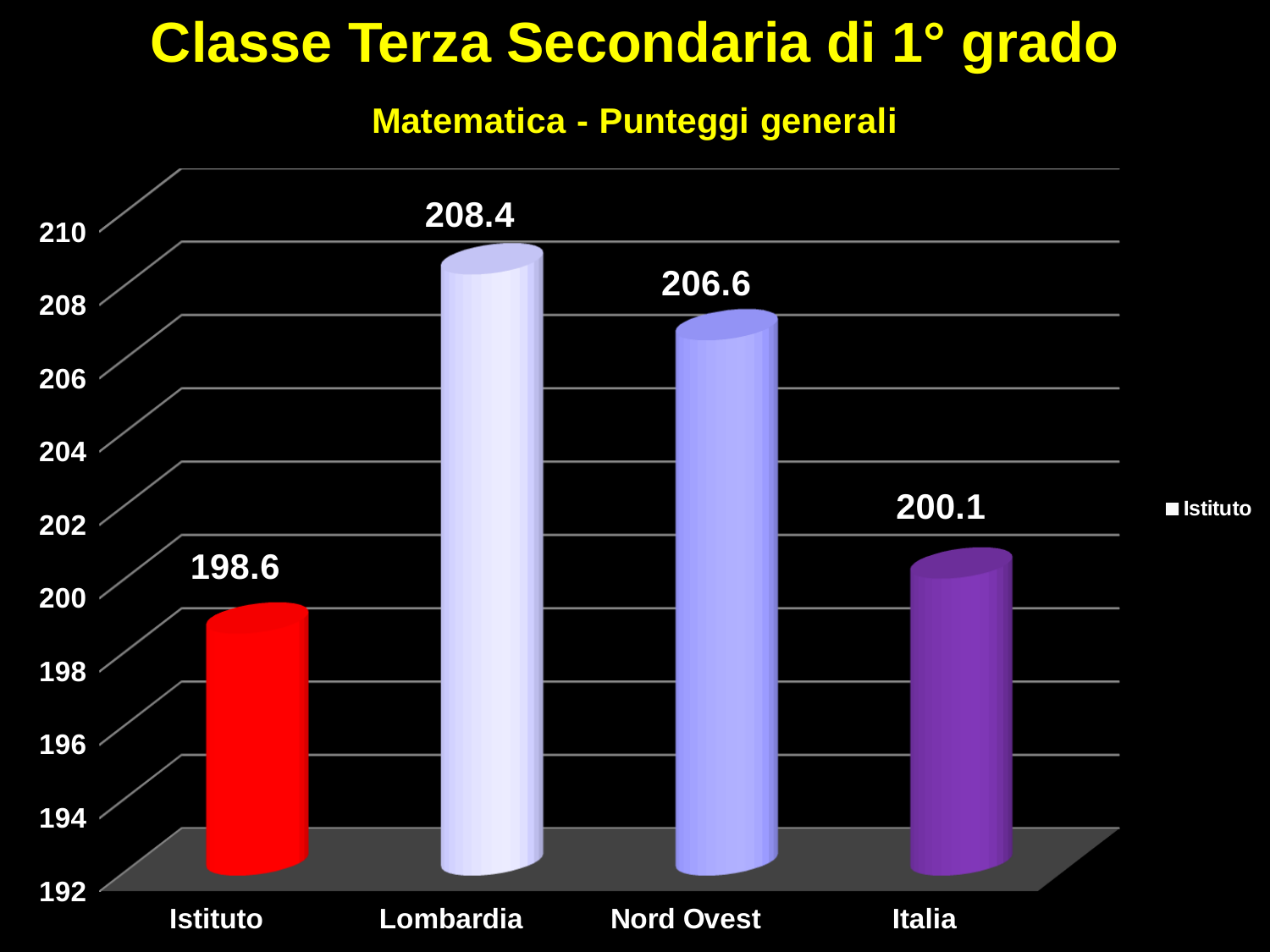
What is the value for Lombardia? 208.4 What is the value for Nord Ovest? 206.6 Which is larger, the value for Nord Ovest or the value for Italia? Nord Ovest What is the value for Italia? 200.1 What is the value for Istituto? 198.6 Is the value for Istituto greater or less than 200? less Which category has the lowest value? Istituto What is the difference between the values for Lombardia and Istituto? 9.8 What is the title of the chart? Matematica - Punteggi generali How many categories are shown on the x axis? 4 What kind of chart is shown on the slide? bar chart Which category has the highest value? Lombardia